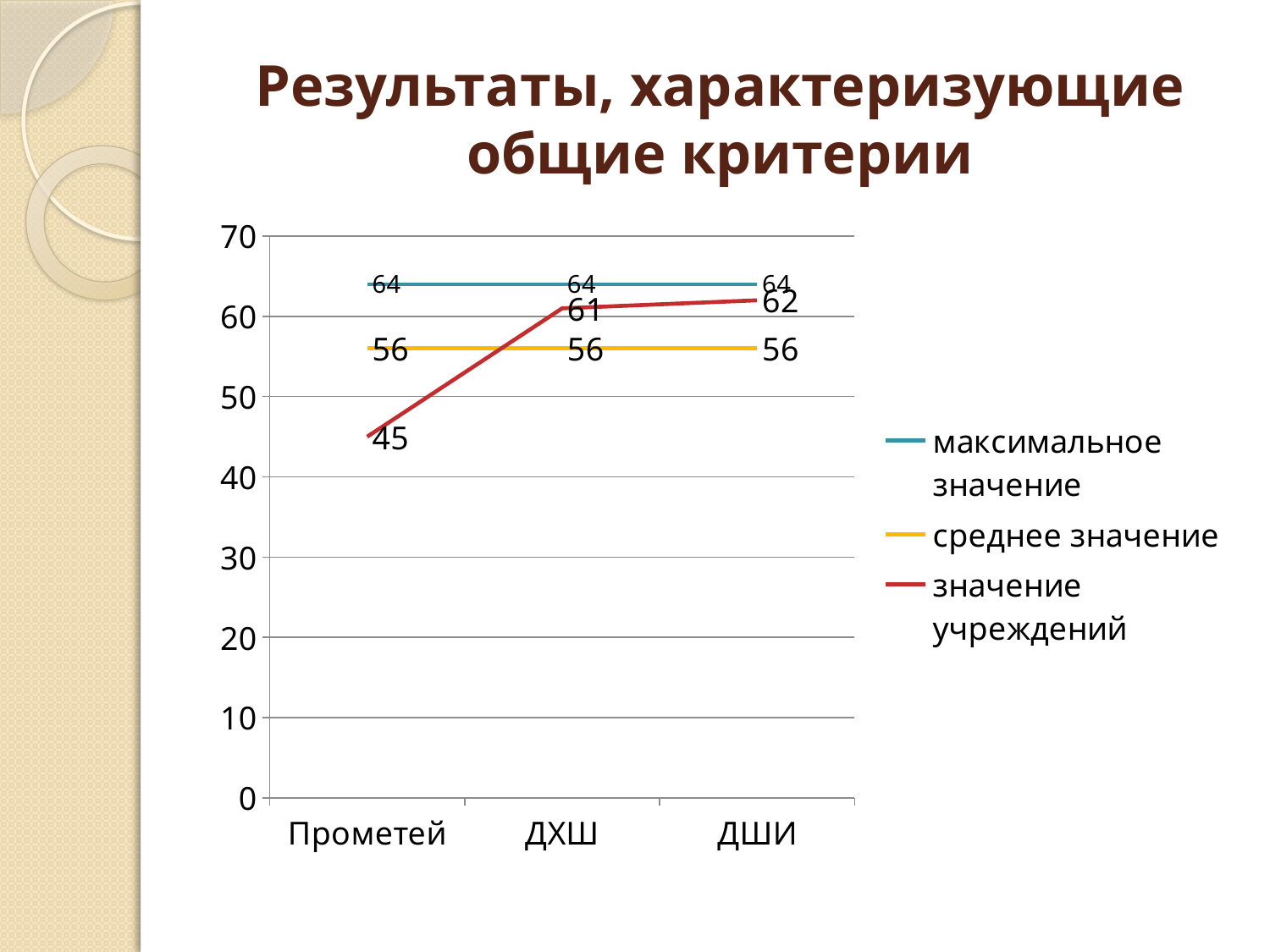
What is the difference between 'максимальное значение' and 'значение учреждений' for Прометей? 19 What is the value of 'значение учреждений' for Прометей? 45 How many categories are shown on the x axis? 3 Does the 'значение учреждений' series rise or fall from Прометей to ДШИ? rise Which category has the lowest value for 'значение учреждений'? Прометей What is the value of 'максимальное значение' for ДХШ? 64 What type of chart is shown on the slide? line chart What is the value of 'значение учреждений' for ДХШ? 61 What is the value of 'значение учреждений' for ДШИ? 62 Which is larger for ДХШ: 'значение учреждений' or 'среднее значение'? значение учреждений What is the value of 'среднее значение' for ДШИ? 56 How many series does the legend list? 3